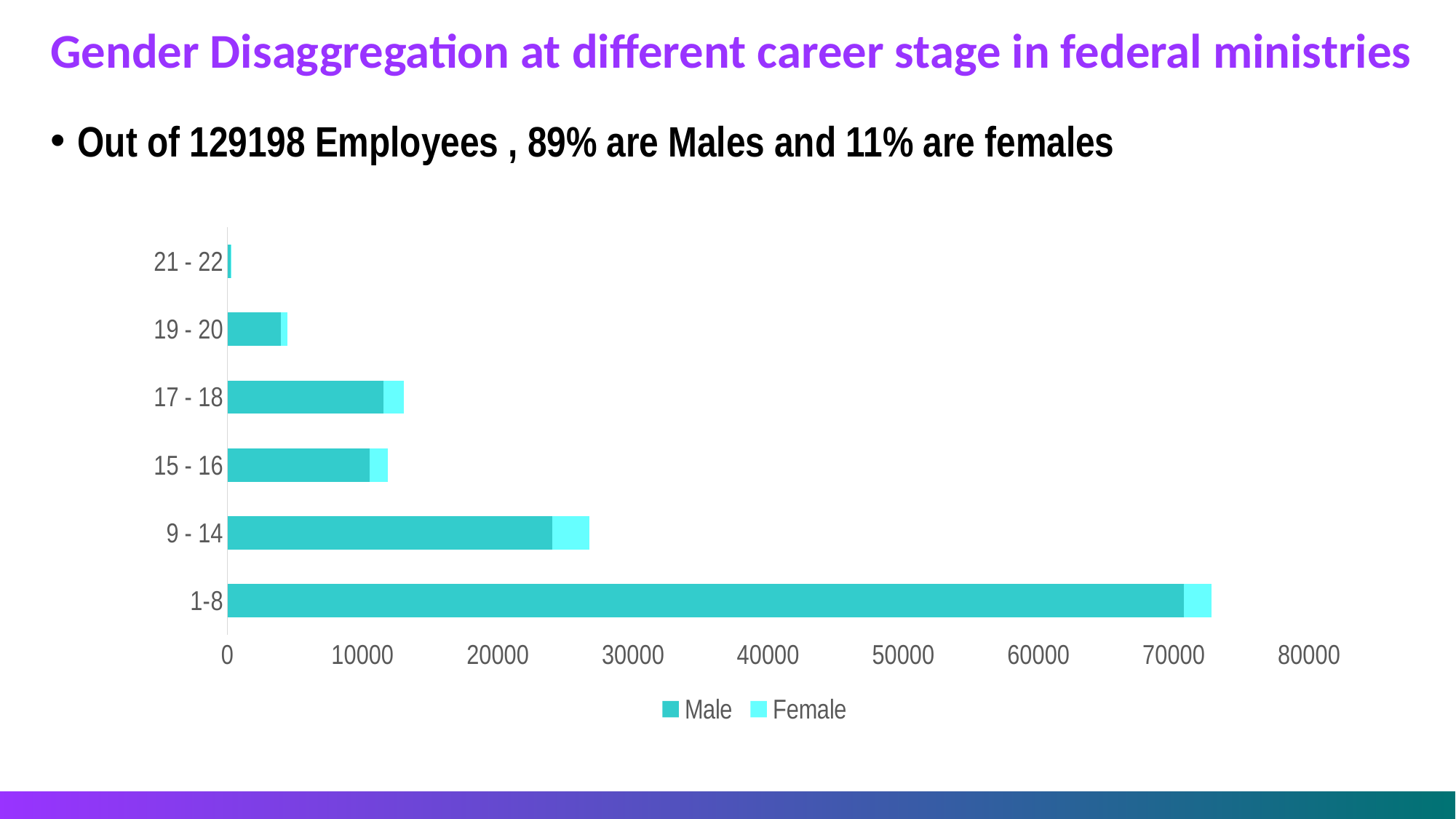
How many career-stage categories are plotted on the chart? 6 What kind of chart is shown on the slide? Stacked bar chart Is the Male value for the 9 - 14 category larger or smaller than the Male value for the 15 - 16 category? larger Is the total bar length for the 1-8 category greater or less than 70000? greater Which series are listed in the chart legend? Male and Female Which career-stage category has the shortest bar? 21 - 22 Is the Male value for the 9 - 14 category greater or less than 30000? less Is the total bar length for the 19 - 20 category greater or less than 10000? less In every category, which series has the larger segment, Male or Female? Male How many series does the chart legend list? 2 Which career-stage category has the longest bar? 1-8